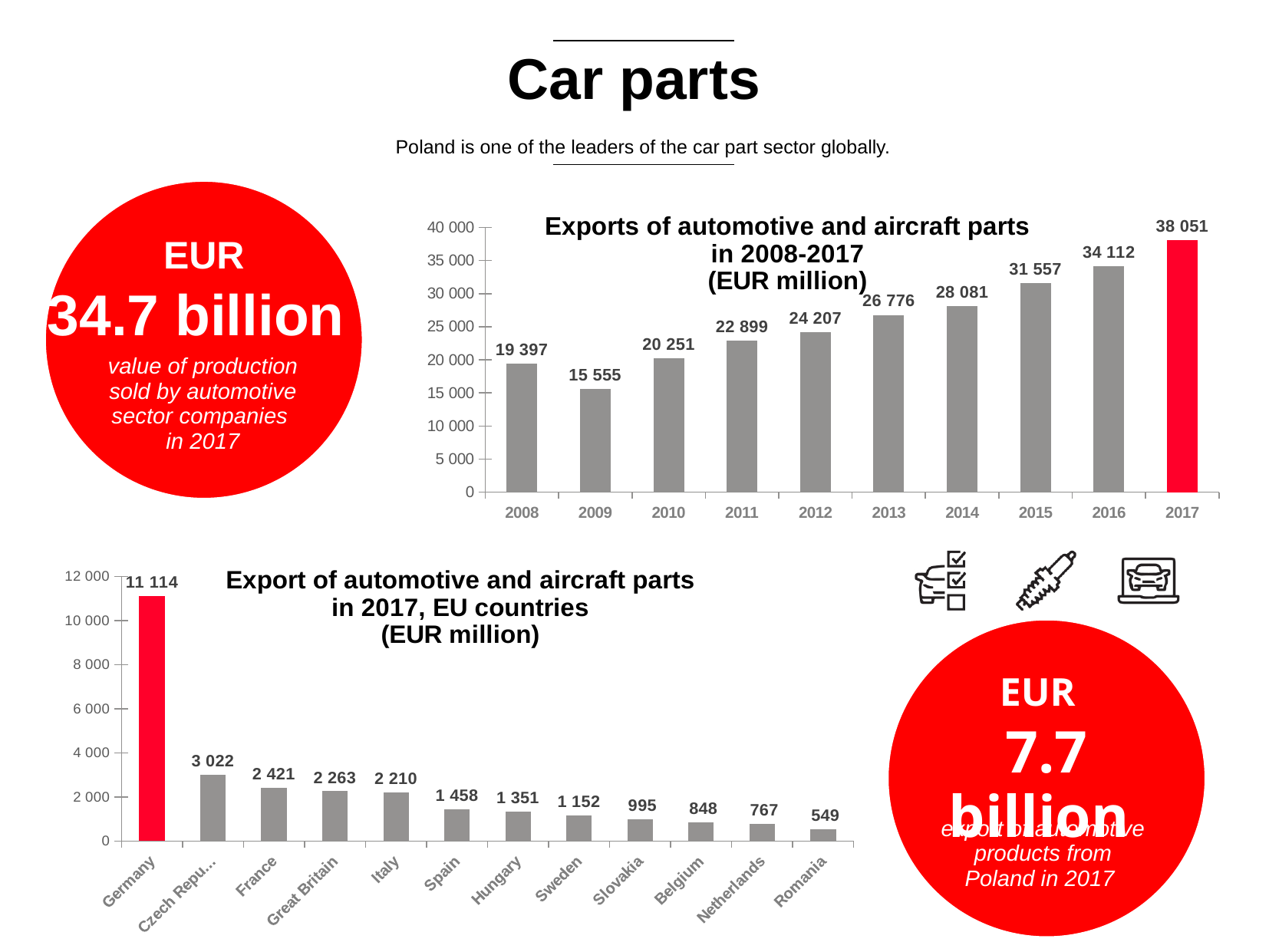
What kind of chart is 'Exports of automotive and aircraft parts in 2008-2017'? bar chart In the chart 'Export of automotive and aircraft parts in 2017, EU countries', how many countries are shown? 12 In the chart 'Exports of automotive and aircraft parts in 2008-2017', what is the value for 2017? 38 051 In the chart 'Export of automotive and aircraft parts in 2017, EU countries', which is larger, the value for France or the value for Spain? France In the chart 'Exports of automotive and aircraft parts in 2008-2017', which year has the lowest value? 2009 In the chart 'Exports of automotive and aircraft parts in 2008-2017', do the values generally rise or fall from 2009 to 2017? rise In the chart 'Export of automotive and aircraft parts in 2017, EU countries', what is the value for Romania? 549 In the chart 'Exports of automotive and aircraft parts in 2008-2017', what is the value for 2009? 15 555 In the chart 'Exports of automotive and aircraft parts in 2008-2017', how many years are shown on the x axis? 10 In the chart 'Export of automotive and aircraft parts in 2017, EU countries', which country has the highest value? Germany In the chart 'Exports of automotive and aircraft parts in 2008-2017', what is the difference between the 2017 and 2016 values? 3 939 In the chart 'Export of automotive and aircraft parts in 2017, EU countries', what is the value for Germany? 11 114